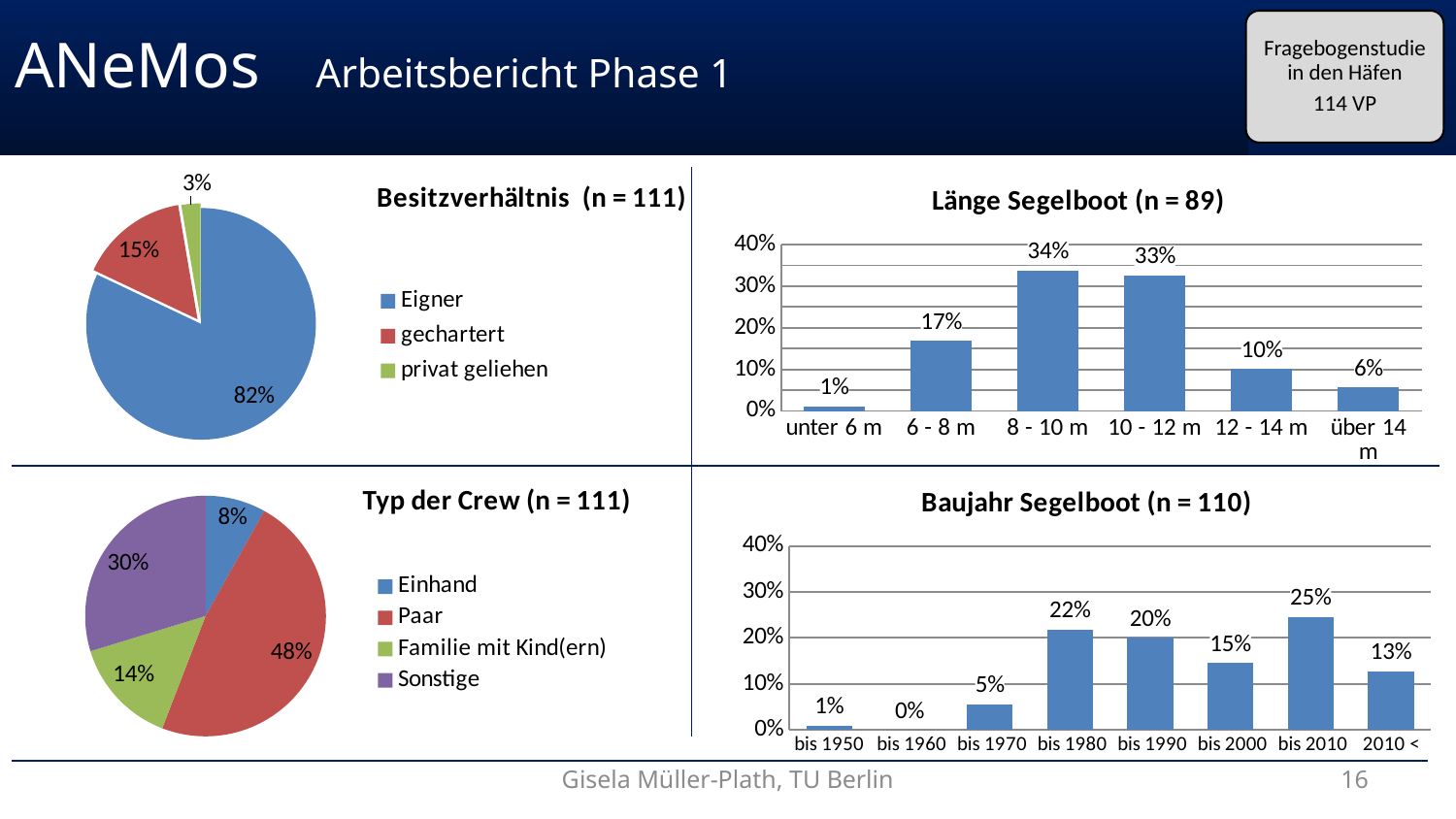
In the 'Besitzverhältnis (n = 111)' pie chart, which category has the smallest slice? privat geliehen In the 'Baujahr Segelboot (n = 110)' chart, which category has the highest value? bis 2010 In the 'Typ der Crew (n = 111)' pie chart, what is the difference between the shares for Paar and Familie mit Kind(ern)? 34% In the 'Länge Segelboot (n = 89)' chart, what is the value for 6 - 8 m? 17% In the 'Länge Segelboot (n = 89)' chart, which length category has the highest value? 8 - 10 m What kind of chart is 'Länge Segelboot (n = 89)'? bar chart In the 'Besitzverhältnis (n = 111)' pie chart, what share is labelled for Eigner? 82% How many categories are shown on the x axis of the 'Baujahr Segelboot (n = 110)' chart? 8 In the 'Typ der Crew (n = 111)' pie chart, what share is shown for Sonstige? 30% In the 'Typ der Crew (n = 111)' pie chart, which category has the largest slice? Paar How many entries does the legend of the 'Typ der Crew (n = 111)' pie chart list? 4 In the 'Baujahr Segelboot (n = 110)' chart, is the value for bis 1980 larger or the value for bis 1990? bis 1980